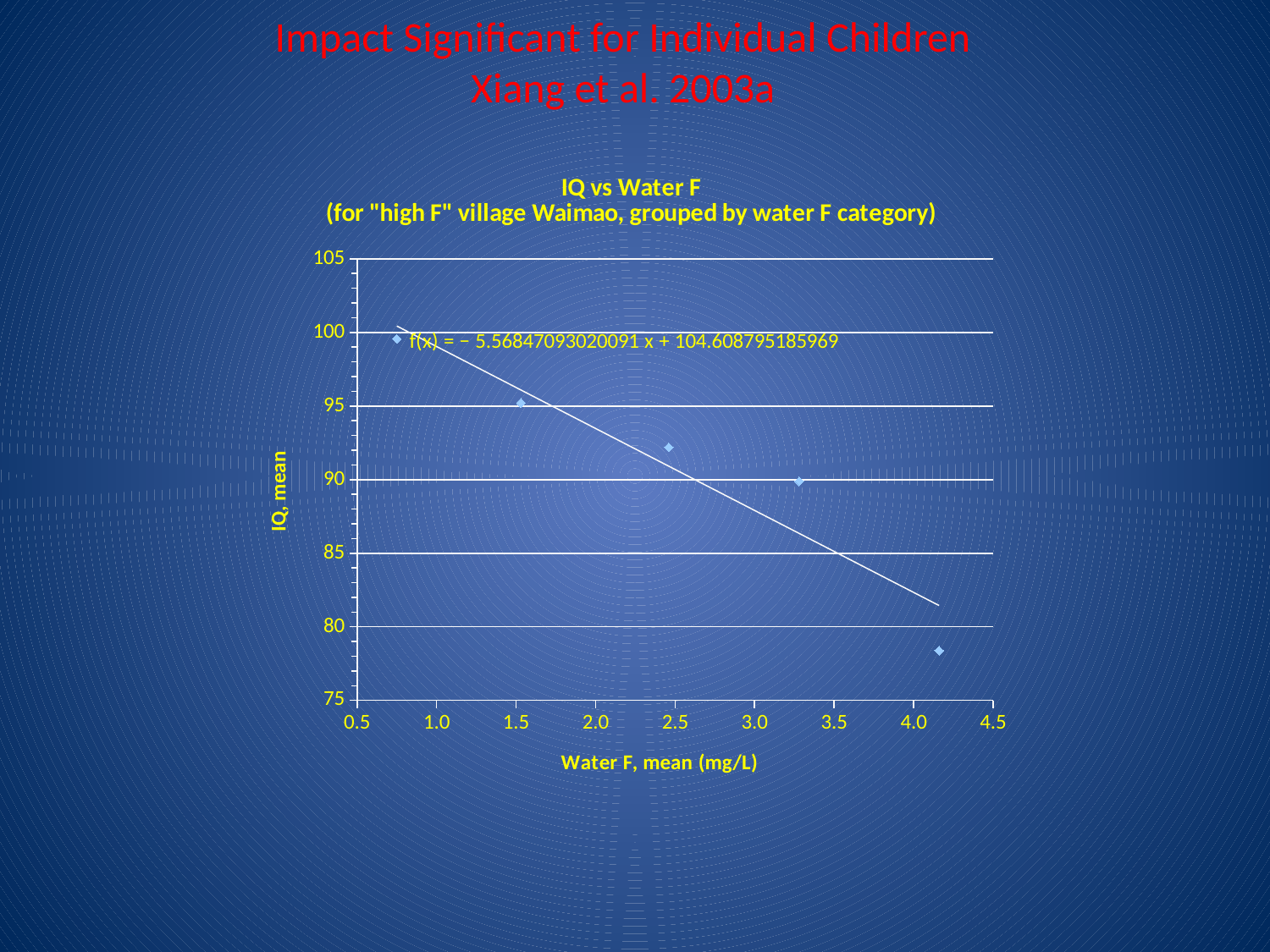
Is the IQ value for the point with the lowest water F (below 1.0 mg/L) greater or less than 95? greater Is the IQ value for the point with the highest water F (around 4.0 mg/L) greater or less than 80? less What is the label of the x axis? Water F, mean (mg/L) Is the IQ value for the point near 3.3 mg/L water F greater or less than 85? greater How many data points are plotted in the chart? 5 What is the slope of the fitted trendline equation shown on the chart? − 5.56847093020091 What is the intercept of the fitted trendline equation shown on the chart? 104.608795185969 Do the IQ values rise or fall as water F increases along the x axis? fall Which point has the higher IQ: the one with the lowest water F or the one with the highest water F? the one with the lowest water F What is the label of the y axis? IQ, mean What kind of chart is shown on the slide? scatter chart